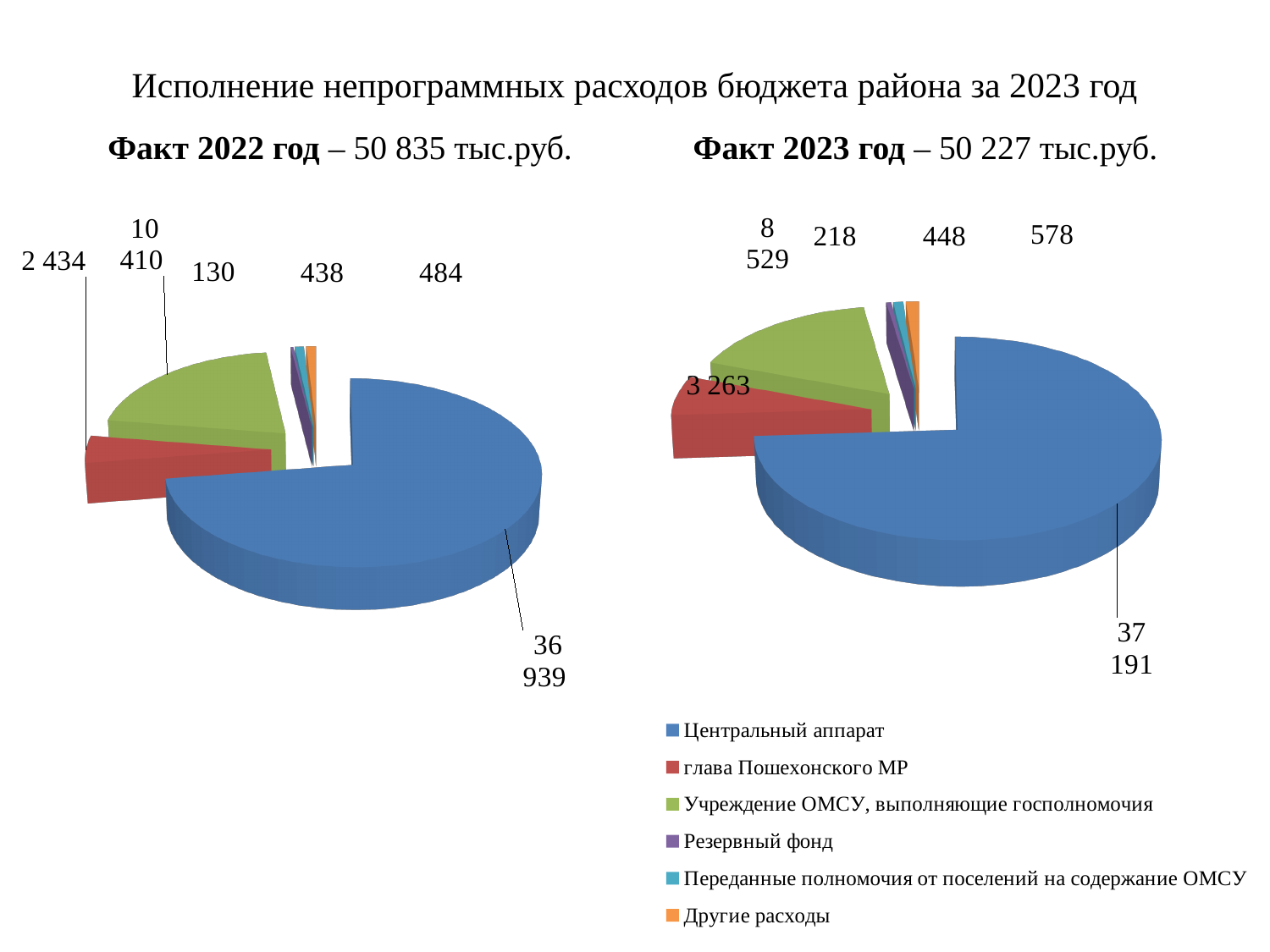
How much larger is the value for Центральный аппарат in the 'Факт 2023 год' chart than in the 'Факт 2022 год' chart? 252 In the 'Факт 2023 год' chart, what is the value for Учреждение ОМСУ, выполняющие госполномочия? 8 529 In the 'Факт 2022 год' chart, what is the smallest value shown? 130 What type of chart is used on this slide? pie chart In the 'Факт 2023 год' chart, what is the value for Центральный аппарат? 37 191 What is the difference between the value for Учреждение ОМСУ, выполняющие госполномочия in the 'Факт 2022 год' chart (10 410) and in the 'Факт 2023 год' chart (8 529)? 1 881 In the 'Факт 2022 год' chart, what is the value for Центральный аппарат? 36 939 In the 'Факт 2023 год' chart, what is the value for глава Пошехонского МР? 3 263 Is the value for глава Пошехонского МР larger in the 'Факт 2022 год' chart or the 'Факт 2023 год' chart? Факт 2023 год In the 'Факт 2022 год' chart, which category has the largest slice? Центральный аппарат How many categories does the legend list? 6 In the 'Факт 2022 год' chart, what is the value for глава Пошехонского МР? 2 434